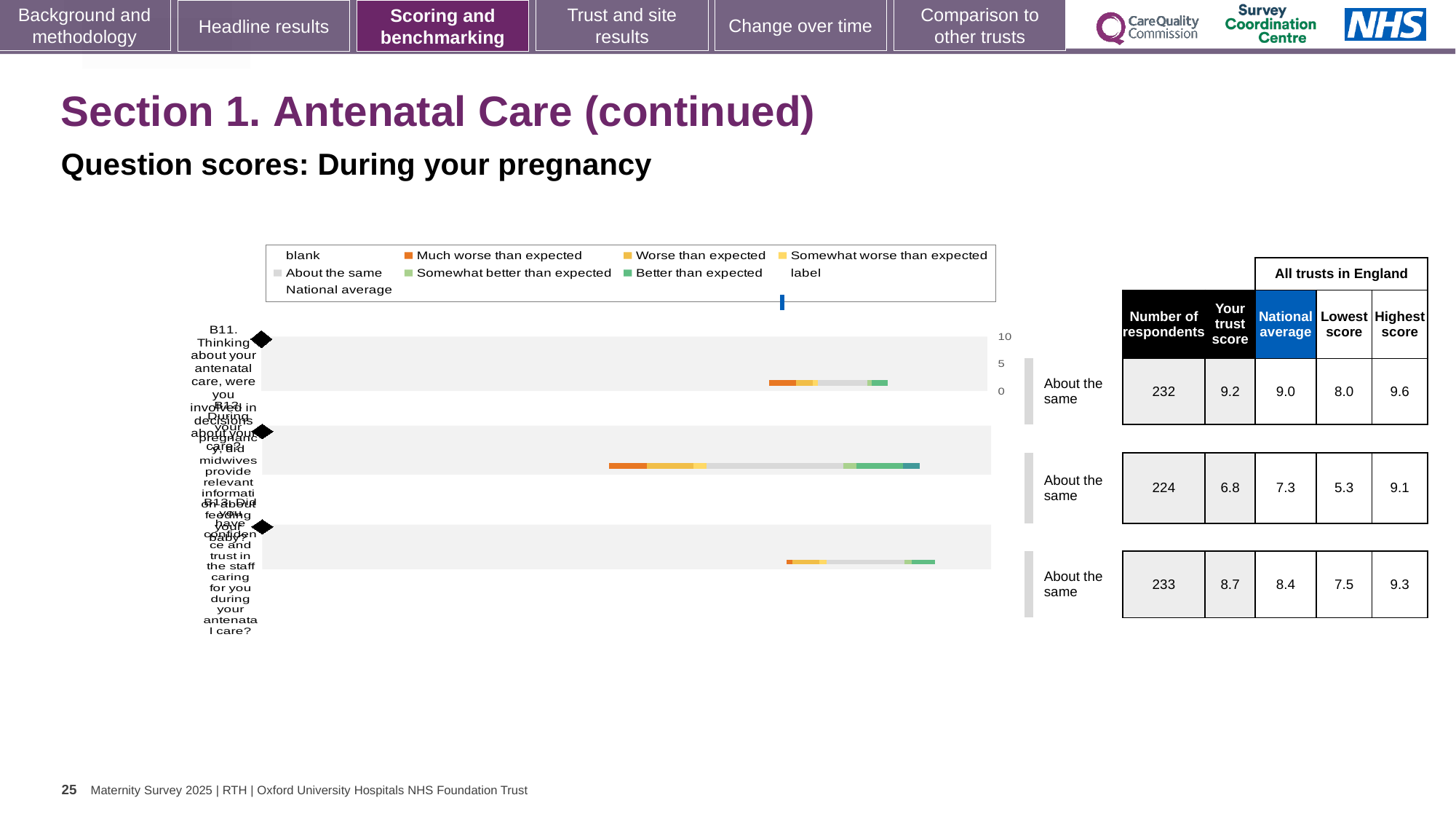
How many questions (bars) are plotted in the chart? 3 Which question has the lowest number of respondents in the table? B12 Which question has the highest 'Your trust score' in the table? B11 In the table beside the chart, how many respondents answered question B13? 233 What colour does the legend use for 'Much worse than expected'? Orange In the table beside the chart, what is the national average for question B12? 7.3 What benchmark category is shown next to the bar for question B11? About the same In the table beside the chart, what is 'Your trust score' for question B11? 9.2 What is the highest value shown on the chart's numeric axis? 10 What kind of chart is shown on the slide? Bar chart For question B11, what is the difference between the highest score and the lowest score in the table? 1.6 For question B12, which is larger: your trust score or the national average? National average